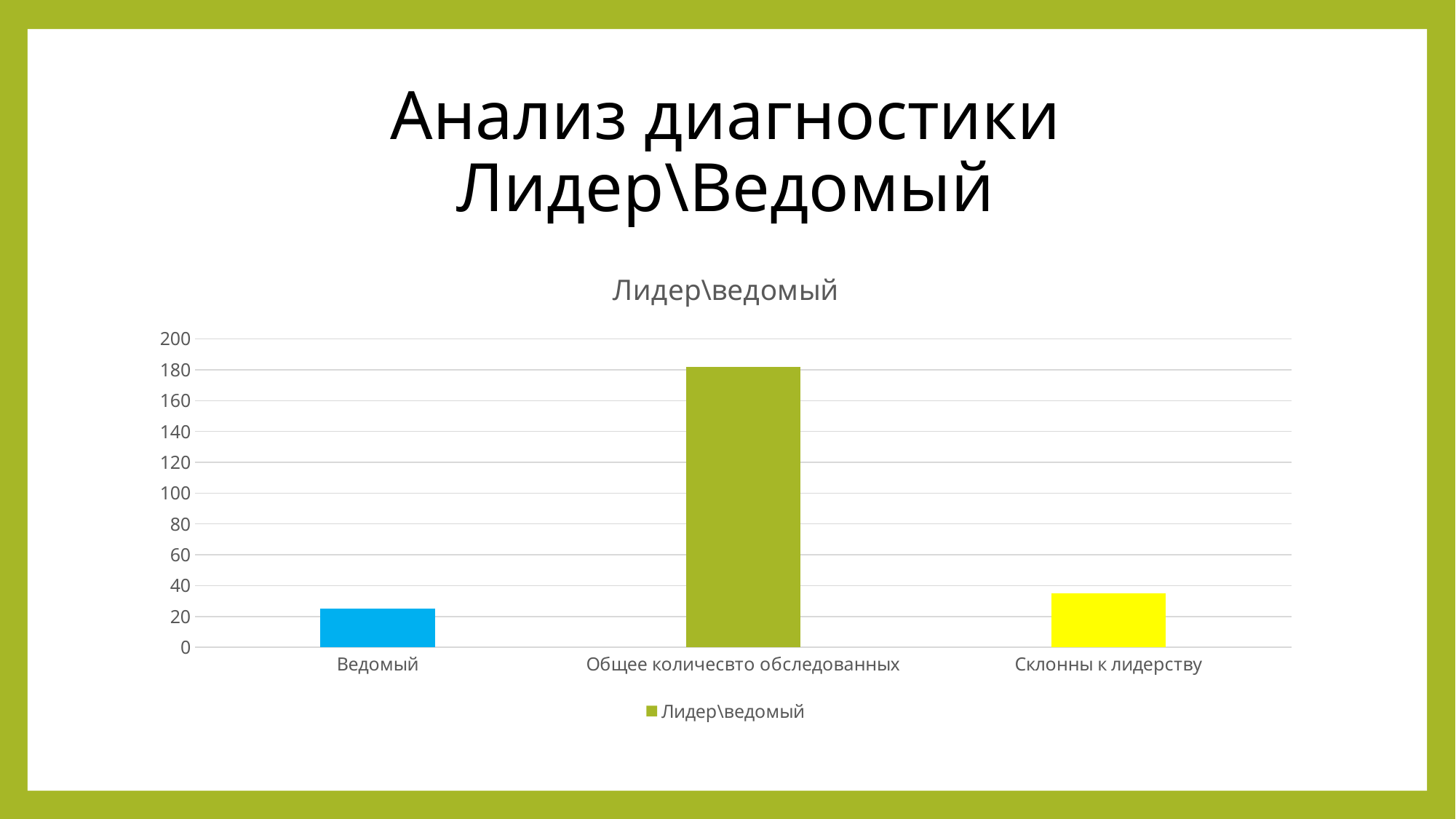
Which category has the highest value in the chart? Общее количесвто обследованных Which is larger, the value for Ведомый or the value for Склонны к лидерству? Склонны к лидерству What is the title of the chart? Лидер\ведомый What kind of chart is shown on the slide? bar chart Is the value for Склонны к лидерству greater or less than 20? greater How many categories are plotted on the x axis of the chart? 3 What colour is the bar for Склонны к лидерству? yellow Is the value for Ведомый greater or less than 40? less How many series does the chart legend list? 1 Is the value for Общее количесвто обследованных greater or less than 200? less Which category has the lowest value in the chart? Ведомый